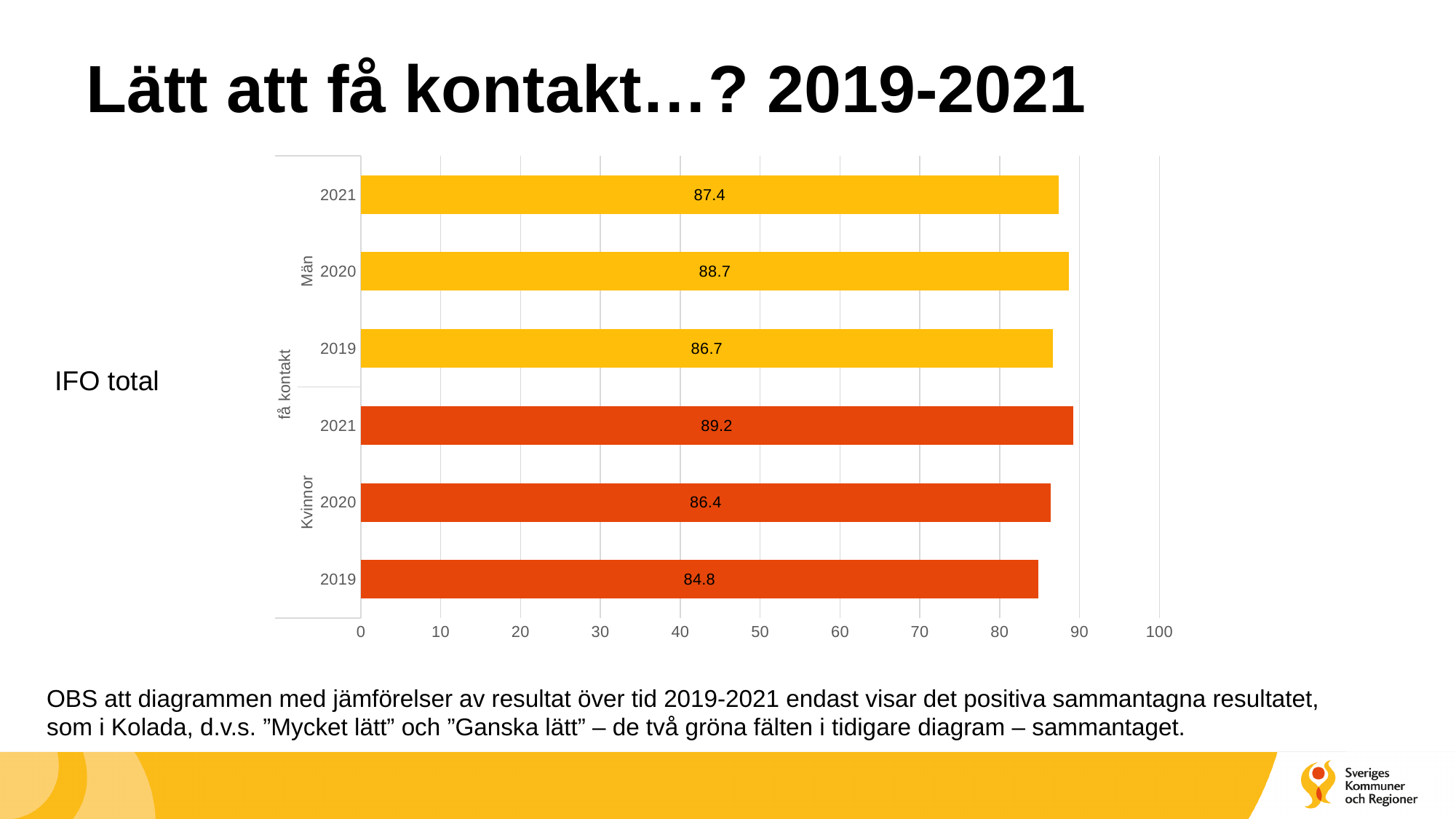
Which is larger, the Män 2021 value or the Kvinnor 2020 value? Män 2021 Which bar has the lowest value? Kvinnor 2019 What is the value for Män in 2021? 87.4 What is the value for Kvinnor in 2019? 84.8 What is the difference between the Män 2020 value and the Män 2019 value? 2.0 What is the value for Kvinnor in 2021? 89.2 Which bar has the highest value? Kvinnor 2021 How many bars are plotted in the chart? 6 Do the Kvinnor values rise or fall from 2019 to 2021? Rise What kind of chart is shown on the slide? Bar chart What is the difference between the Kvinnor 2021 value and the Kvinnor 2019 value? 4.4 What is the value for Män in 2020? 88.7